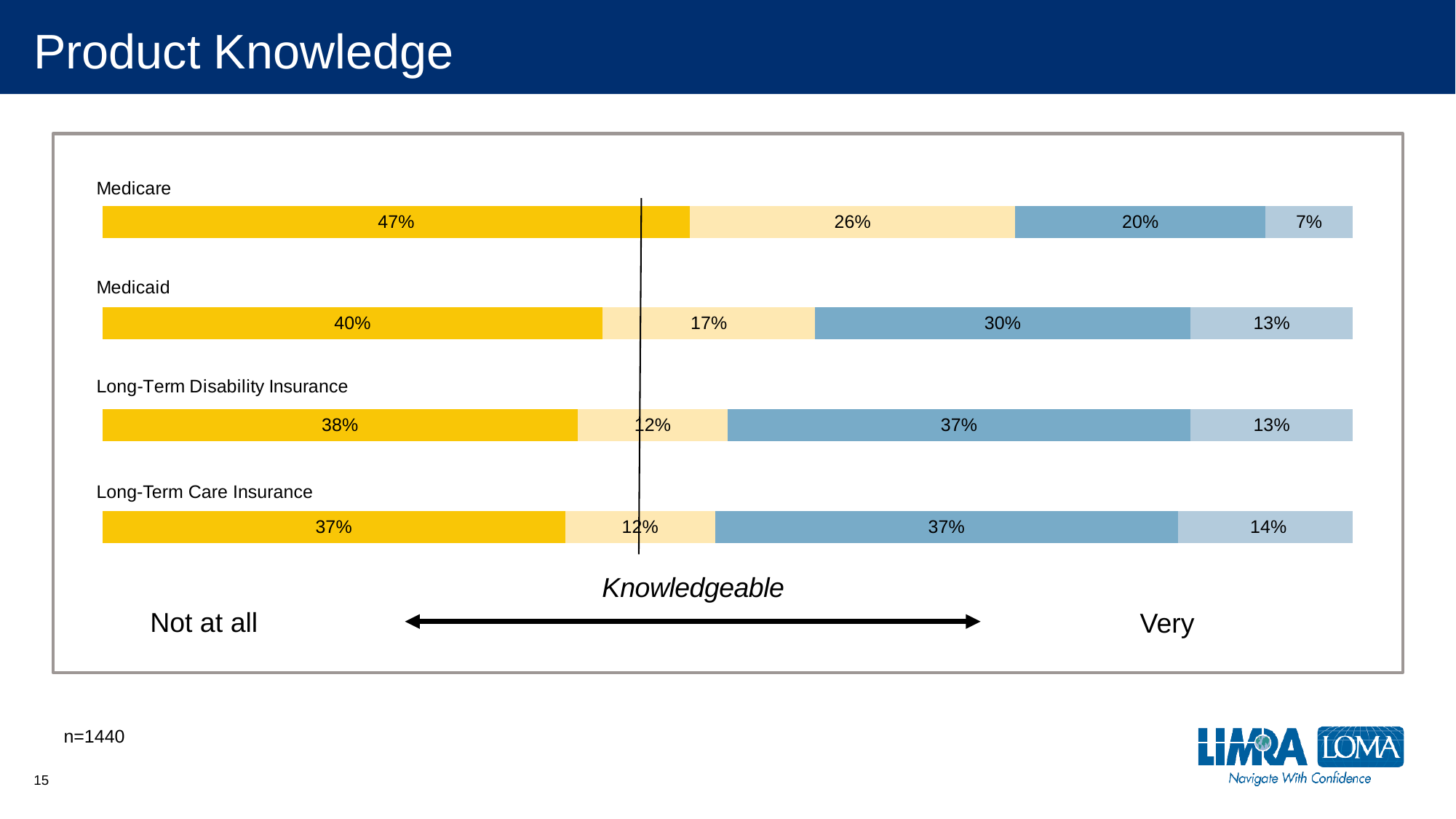
Which product has the lowest value in its rightmost (light blue) segment? Medicare What is the total of the Medicare bar's segments? 100% How many products are shown in the chart? 4 What kind of chart is shown on the slide? Stacked bar chart What percentage is shown in the first (leftmost, dark yellow) segment of the Medicare bar? 47% What percentage is shown in the last (rightmost, light blue) segment of the Medicaid bar? 13% Which is larger: the third (blue) segment for Medicaid or the third (blue) segment for Medicare? Medicaid What is the difference between the leftmost segment values for Medicare and Medicaid? 7% What percentage is shown in the third (blue) segment of the Long-Term Care Insurance bar? 37% Which product has the highest value in its leftmost (dark yellow) segment? Medicare What percentage is shown in the second (light yellow) segment of the Long-Term Disability Insurance bar? 12% What sample size is noted below the chart? n=1440